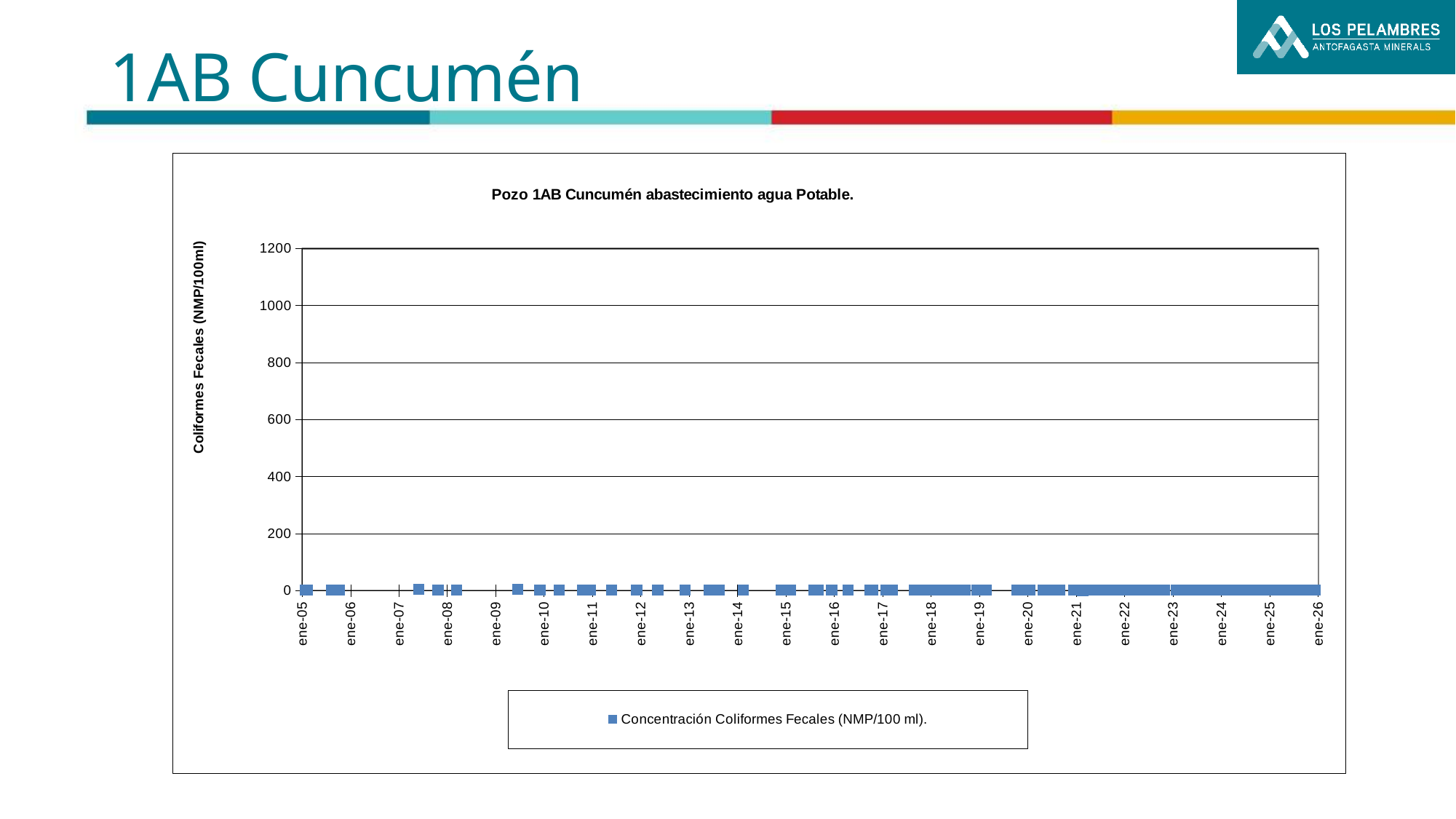
What kind of chart is shown on the slide? scatter chart How many series does the legend list? 1 Is the value plotted at ene-10 greater or less than 200? less Do the plotted values rise, fall, or stay flat from ene-05 to ene-26? stay flat What is the title of the chart? Pozo 1AB Cuncumén abastecimiento agua Potable. Is the value plotted at ene-20 greater or less than 400? less What is the first label on the x axis? ene-05 What is the highest tick value shown on the y axis? 1200 How many labels are shown along the x axis? 22 What is the legend entry for the plotted series? Concentración Coliformes Fecales (NMP/100 ml). What is the last label on the x axis? ene-26